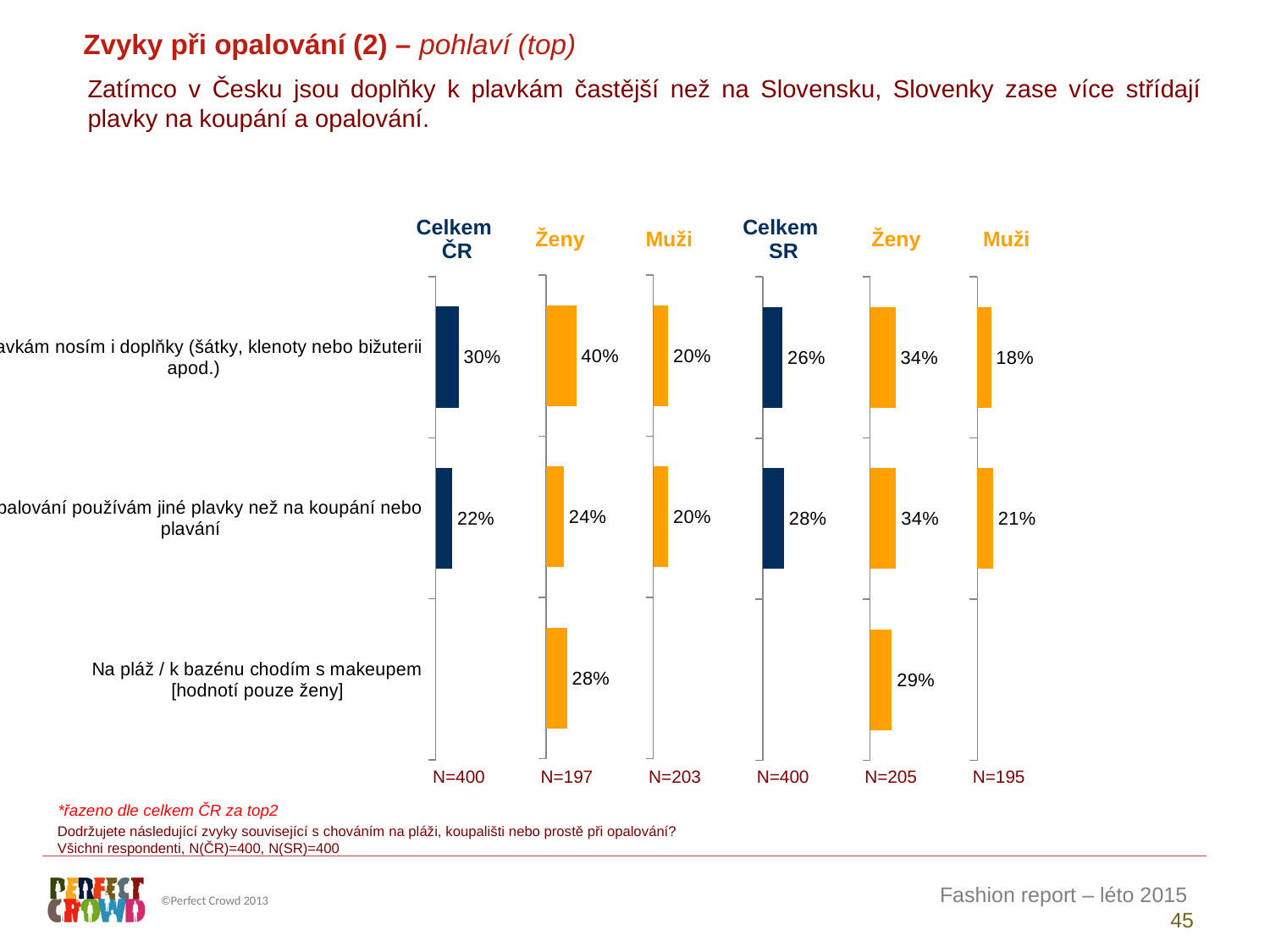
In the Ženy column under Celkem SR, what is the value for 'Na pláž / k bazénu chodím s makeupem [hodnotí pouze ženy]'? 29% What is the difference between the Ženy ČR value (40%) and the Muži ČR value (20%) for the row about wearing doplňky (šátky, klenoty nebo bižuterii apod.)? 20 percentage points For the row about using jiné plavky než na koupání nebo plavání, which is larger: the Celkem ČR value or the Celkem SR value? Celkem SR In the Ženy column under Celkem ČR, what is the value for 'Na pláž / k bazénu chodím s makeupem [hodnotí pouze ženy]'? 28% In the Celkem SR column, what is the value for the row about using jiné plavky než na koupání nebo plavání? 28% Across all six columns, which column has the lowest value for the row about wearing doplňky (šátky, klenoty nebo bižuterii apod.)? Muži (SR) In the Muži column under Celkem SR, what is the value for the row about wearing doplňky (šátky, klenoty nebo bižuterii apod.)? 18% Across all six columns, which column has the highest value for the row about wearing doplňky (šátky, klenoty nebo bižuterii apod.)? Ženy (ČR) What is the N shown under the Ženy column for Celkem SR? N=205 What type of chart is used on this slide? Bar chart In the Celkem ČR column, what is the value for the row about wearing doplňky (šátky, klenoty nebo bižuterii apod.) with swimwear? 30% How many rows (categories) are shown in the chart? 3